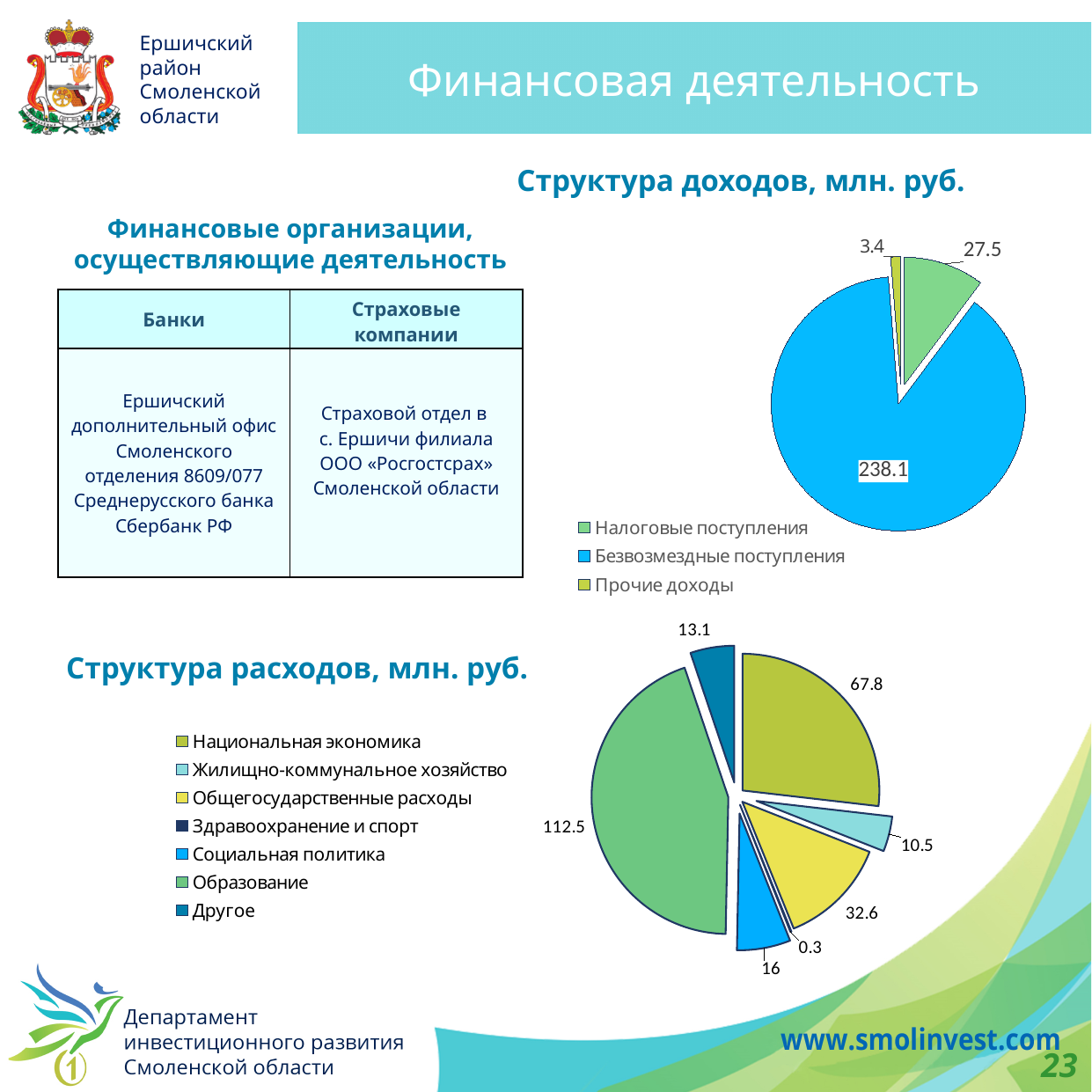
In the chart 'Структура расходов, млн. руб.', which category has the smallest value? Здравоохранение и спорт How many categories are shown in the chart 'Структура расходов, млн. руб.'? 7 In the chart 'Структура доходов, млн. руб.', which category has the largest value? Безвозмездные поступления What type of chart is 'Структура расходов, млн. руб.'? Pie chart In the chart 'Структура доходов, млн. руб.', what is the difference between Налоговые поступления and Прочие доходы? 24.1 In the chart 'Структура расходов, млн. руб.', what is the value for Общегосударственные расходы? 32.6 In the chart 'Структура расходов, млн. руб.', which is larger: Социальная политика or Другое? Социальная политика In the chart 'Структура расходов, млн. руб.', what is the value for Образование? 112.5 In the chart 'Структура доходов, млн. руб.', what is the value for Безвозмездные поступления? 238.1 In the chart 'Структура доходов, млн. руб.', what is the value for Прочие доходы? 3.4 In the chart 'Структура доходов, млн. руб.', how many categories does the legend list? 3 In the chart 'Структура расходов, млн. руб.', what is the difference between Национальная экономика and Жилищно-коммунальное хозяйство? 57.3